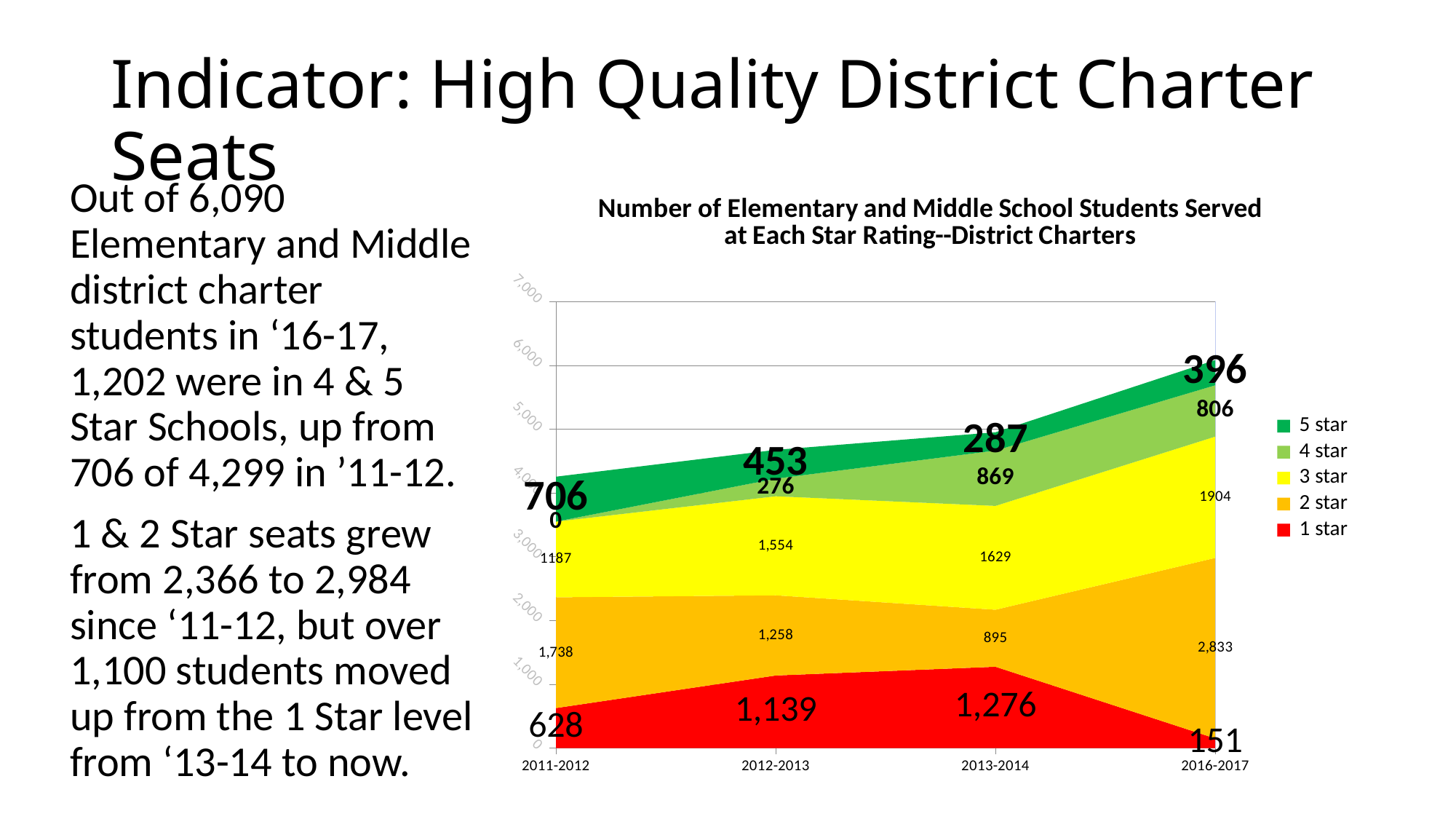
What kind of chart is this? Stacked area chart What is the value for 2 star in 2016-2017? 2,833 What is the value for 5 star in 2011-2012? 706 Which is larger, the 4 star value in 2013-2014 or in 2016-2017? 2013-2014 How many series does the legend list? 5 What is the value for 3 star in 2016-2017? 1904 What is the value for 4 star in 2012-2013? 276 How many years are shown on the x axis? 4 In which year is the 1 star value lowest? 2016-2017 What is the value for 1 star in 2013-2014? 1,276 In which year is the 2 star value highest? 2016-2017 What is the difference between the 1 star values in 2013-2014 and 2016-2017? 1,125